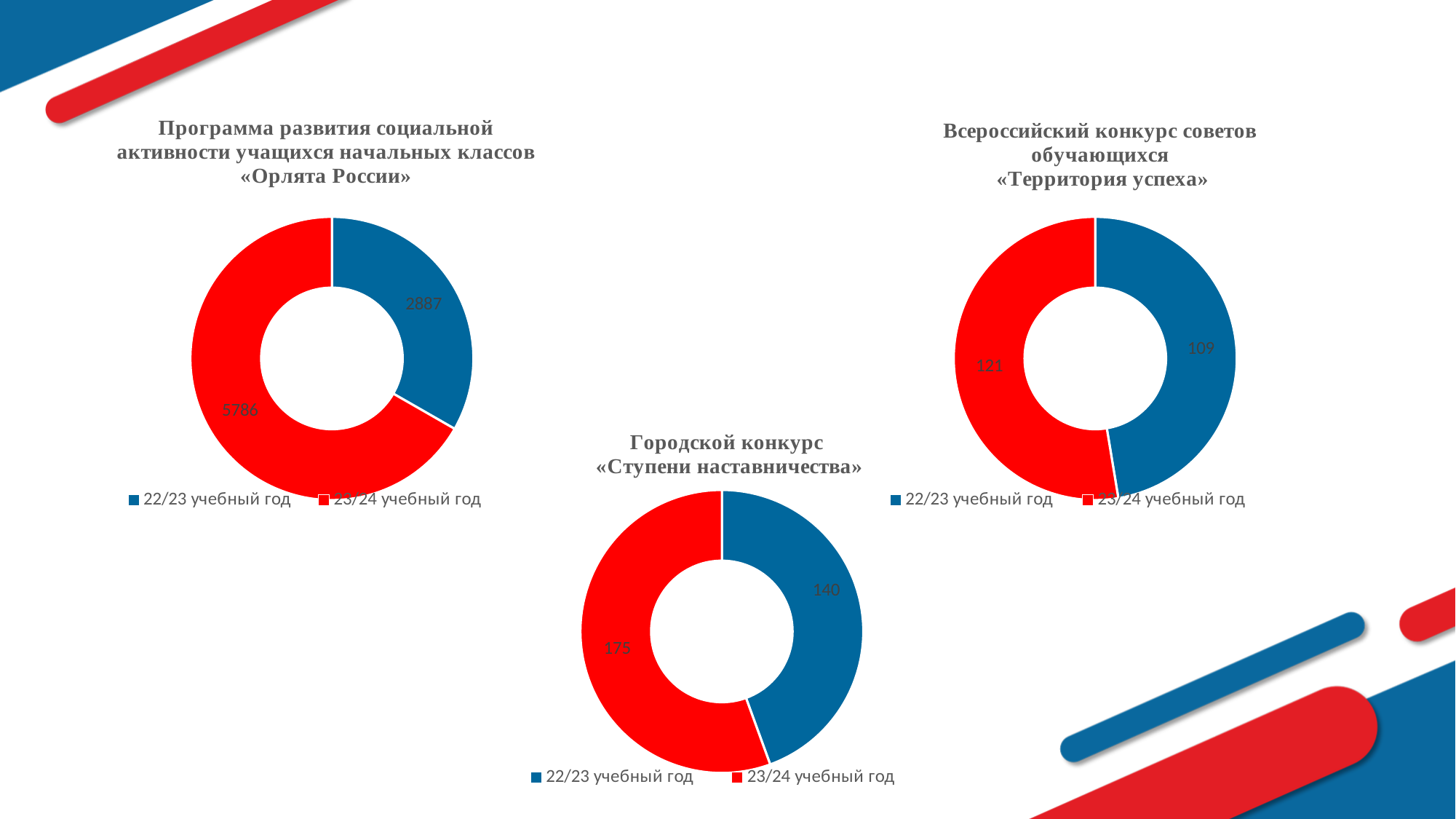
In the «Орлята России» chart, what is the difference between the 23/24 and 22/23 values? 2899 In the «Орлята России» chart, what is the value for 23/24 учебный год? 5786 How many series does the legend of the «Ступени наставничества» chart list? 2 In the «Территория успеха» chart, which colour represents 23/24 учебный год? Red In the «Ступени наставничества» chart, what is the difference between the 23/24 and 22/23 values? 35 In the «Орлята России» chart, what is the value for 22/23 учебный год? 2887 In the «Ступени наставничества» chart, which year has the larger value, 22/23 or 23/24? 23/24 учебный год What type of chart is used for «Орлята России»? Doughnut chart In the «Ступени наставничества» chart, what is the value for 23/24 учебный год? 175 In the «Территория успеха» chart, what is the value for 23/24 учебный год? 121 In the «Территория успеха» chart, what is the total of the two values? 230 In the «Территория успеха» chart, what is the value for 22/23 учебный год? 109